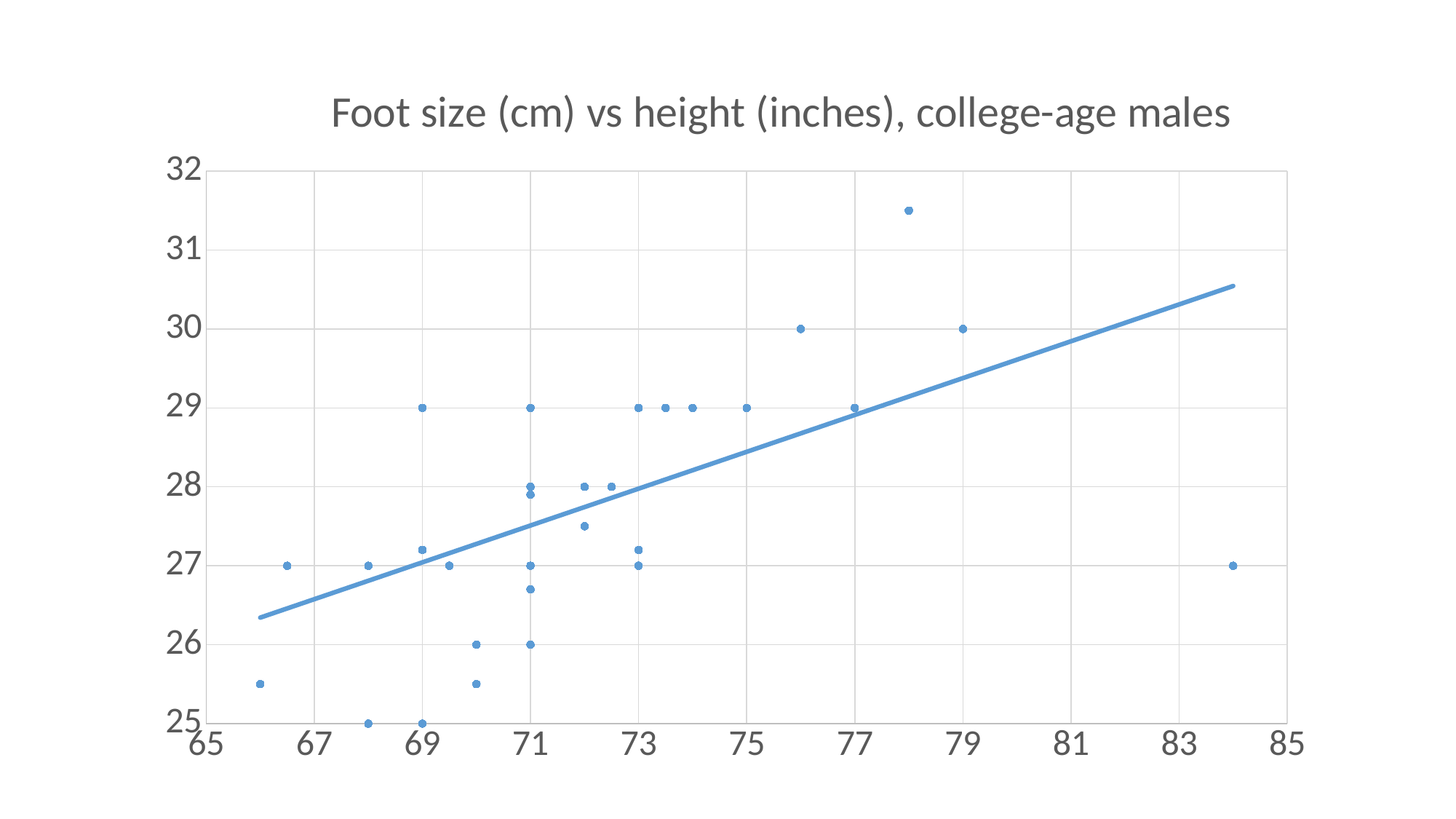
Is the highest plotted foot size greater or less than 31? greater Is the foot size of the point at height 66 greater or less than 26? less What foot size is plotted for the point at height 77? 29 Does the trend line rise or fall as height increases along the x axis? rises What is the difference between the foot size plotted at height 79 and the foot size plotted at height 84? 3 What is the title of the chart? Foot size (cm) vs height (inches), college-age males What kind of chart is shown on the slide? scatter chart What foot size is plotted for the point at height 76? 30 Which is larger, the foot size plotted at height 79 or the foot size plotted at height 84? height 79 What is the lowest foot size plotted at height 69? 25 What foot size is plotted for the point at height 79? 30 What foot size is plotted for the point at height 84? 27